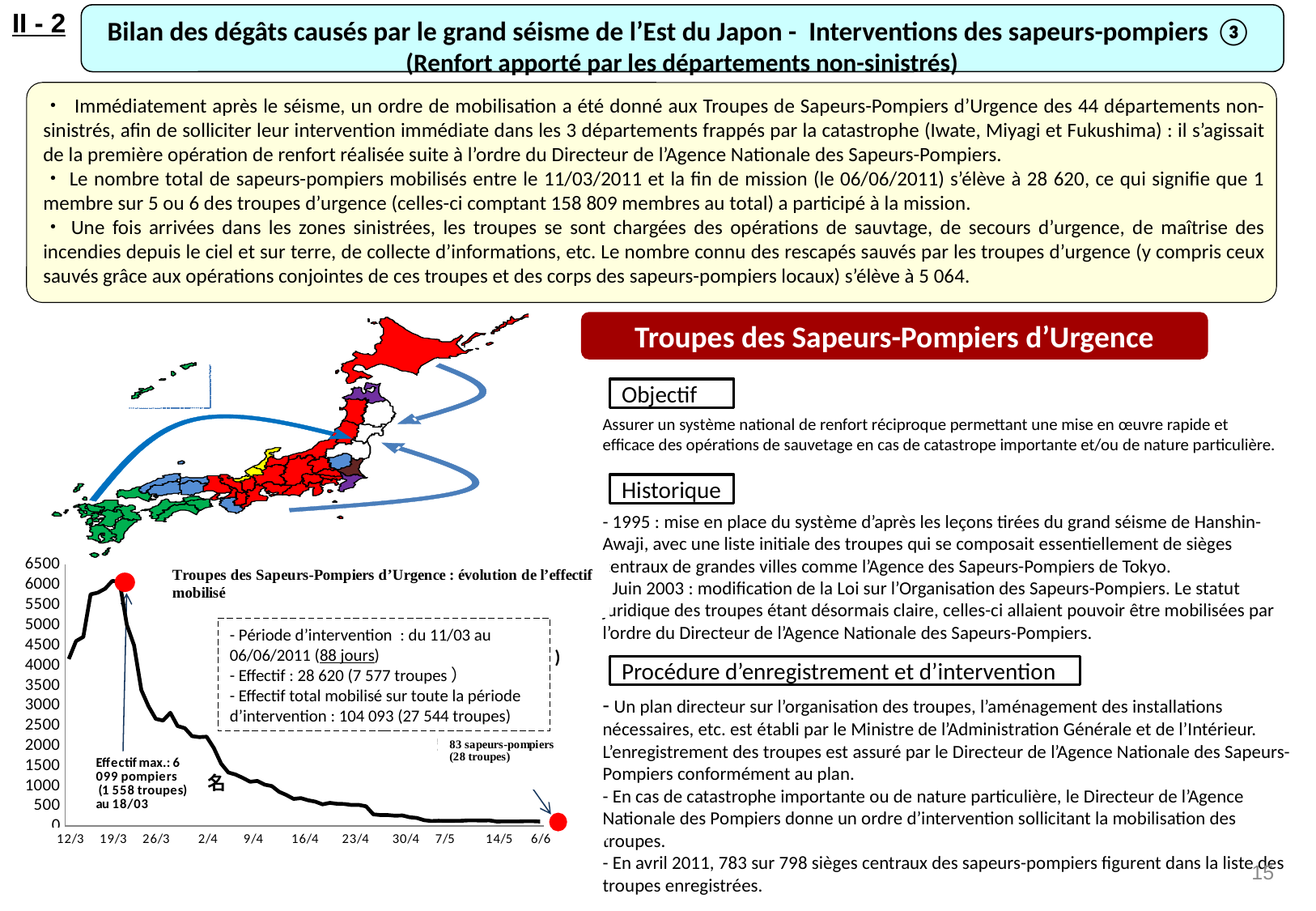
How many firefighters were mobilised at the end of the period (6/6), according to the chart annotation? 83 sapeurs-pompiers Is the value on the chart at 2/4 greater or less than 3000? less Does the mobilised workforce rise or fall along the x axis after its peak around 19/3? Fall What is the difference between the maximum mobilised workforce (6 099) and the final value (83) on the chart? 6 016 What is the title of the chart at the bottom left of the slide? Troupes des Sapeurs-Pompiers d'Urgence : évolution de l'effectif mobilisé What is the highest value shown on the y axis of the chart? 6500 What kind of chart is shown at the bottom left of the slide? Line chart How many troops correspond to the maximum mobilised workforce shown on the chart? 1 558 troupes On what date did the mobilised workforce reach its maximum, according to the chart annotation? 18/03 According to the annotation on the chart, what was the maximum number of firefighters mobilised? 6 099 pompiers Which is larger on the chart: the value at 19/3 or the value at 6/6? 19/3 Is the value on the chart at 12/3 greater or less than 3000? greater